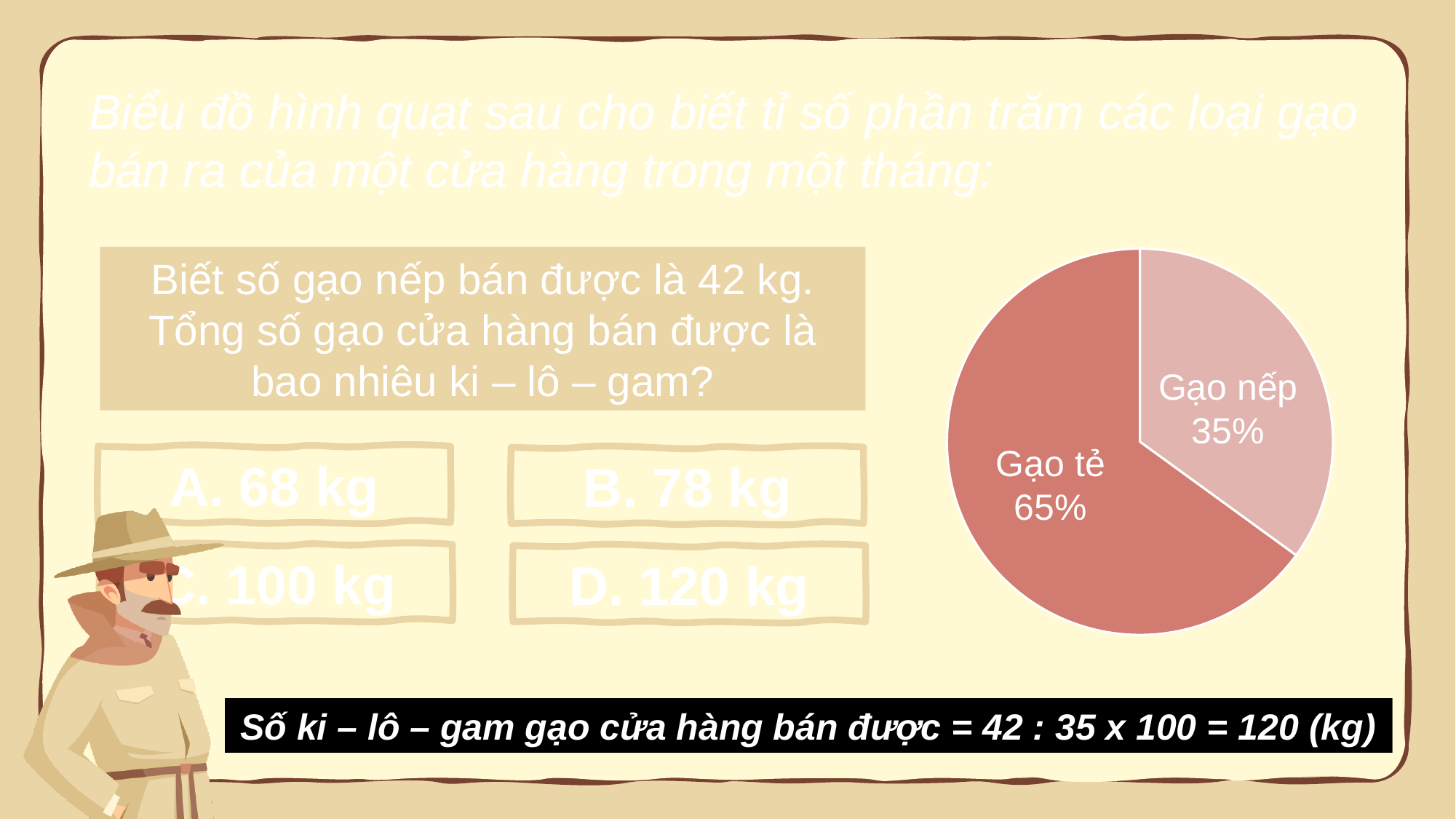
What kind of chart is shown on the slide? pie chart What percentage does the Gạo tẻ slice show? 65% What percentage does the Gạo nếp slice show? 35% Which slice of the pie chart is drawn in the darker red colour? Gạo tẻ Which is larger, the share for Gạo tẻ or the share for Gạo nếp? Gạo tẻ What share of the pie does Gạo tẻ represent? 65% Which slice of the pie chart is the largest? Gạo tẻ What share of the pie does Gạo nếp represent? 35% Which slice of the pie chart is the smallest? Gạo nếp What is the total of the two percentages shown on the pie chart? 100% What is the difference in percentage points between Gạo tẻ and Gạo nếp? 30 How many slices does the pie chart have? 2